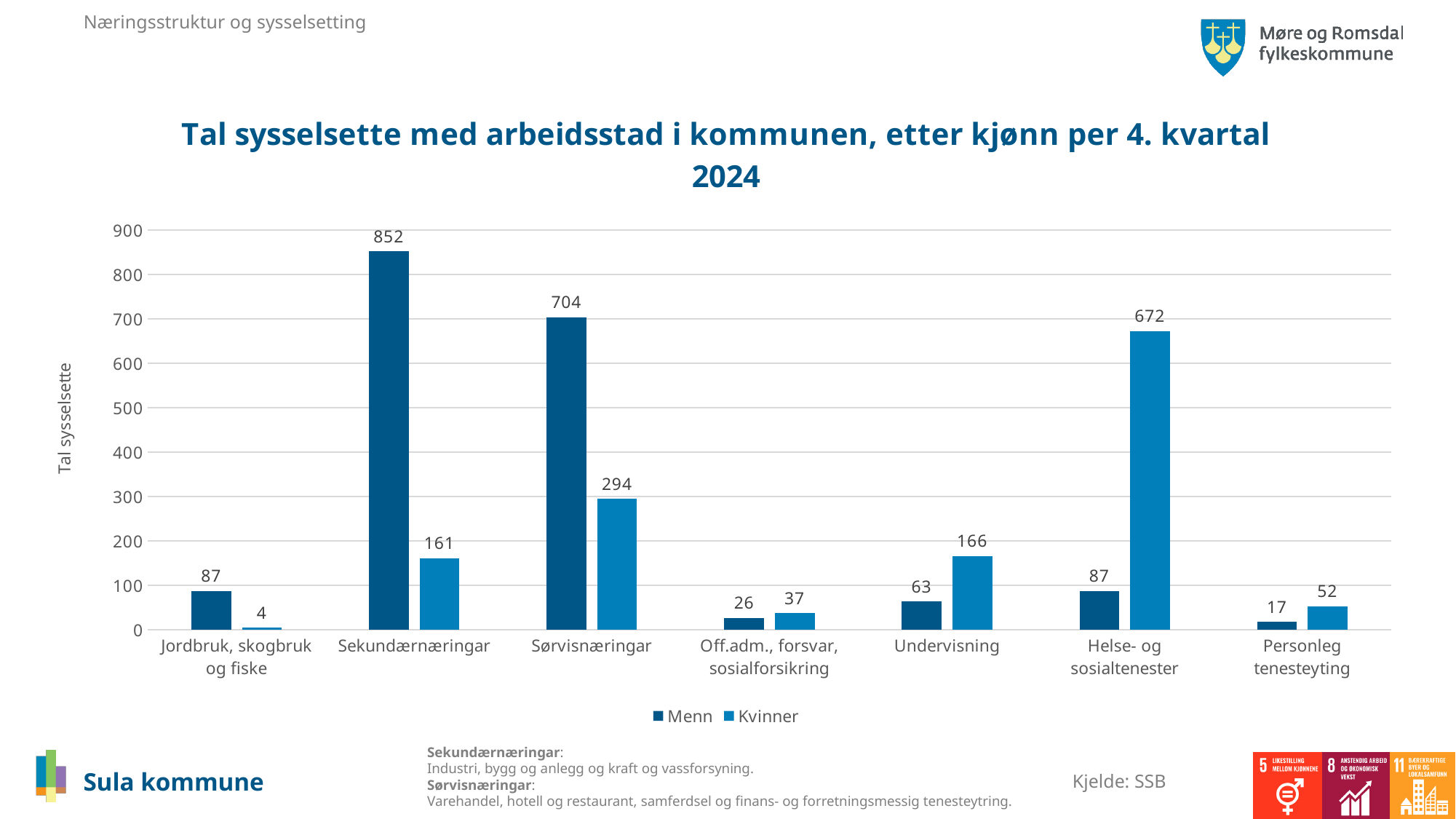
What is the label of the y axis? Tal sysselsette What is the value for Kvinner in Helse- og sosialtenester? 672 What kind of chart is shown on the slide? Bar chart Which category has the highest value for Menn? Sekundærnæringar What is the value for Kvinner in Jordbruk, skogbruk og fiske? 4 What is the value for Menn in Sekundærnæringar? 852 How many categories are shown on the x axis? 7 What is the difference between Menn and Kvinner in Sørvisnæringar? 410 How many series does the legend list? 2 Which is larger in Undervisning, Menn or Kvinner? Kvinner Which category has the lowest value for Kvinner? Jordbruk, skogbruk og fiske Is the value for Kvinner in Sørvisnæringar greater or less than 200? greater